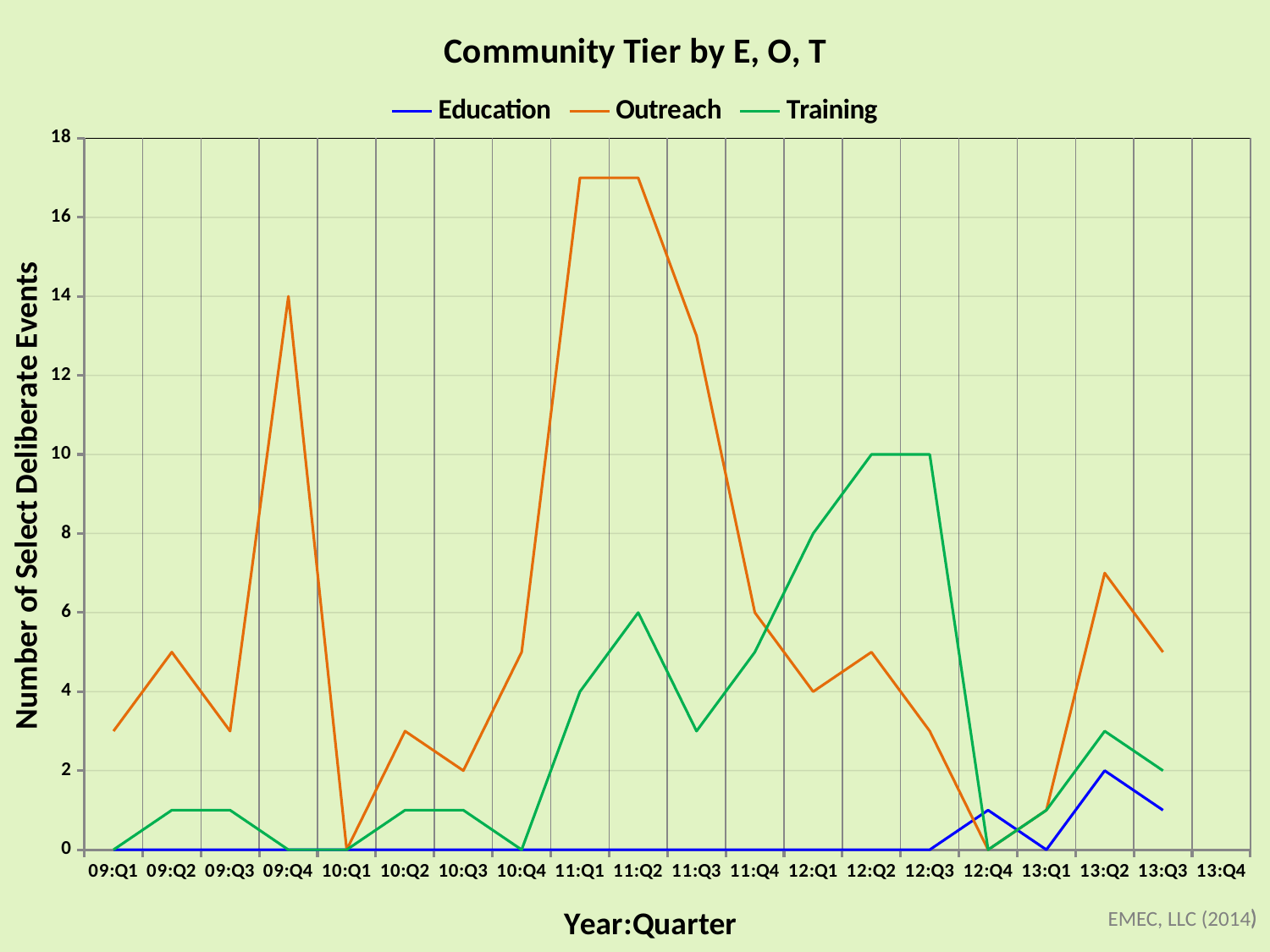
How many series does the legend list? 3 Is the Outreach value at 11:Q1 greater or less than 16? greater How many quarter labels are shown on the x axis? 20 What is the Outreach value at 10:Q1? 0 What is the Training value at 12:Q2? 10 Does the Outreach line rise or fall from 11:Q2 to 12:Q1? Fall What is the Outreach value at 09:Q4? 14 At 09:Q4, which is larger, Outreach or Training? Outreach What is the difference between the Outreach value at 09:Q4 and the Outreach value at 10:Q3? 12 What is the Education value at 13:Q2? 2 Which series has the highest value at 12:Q2? Training What type of chart is shown on the slide? Line chart